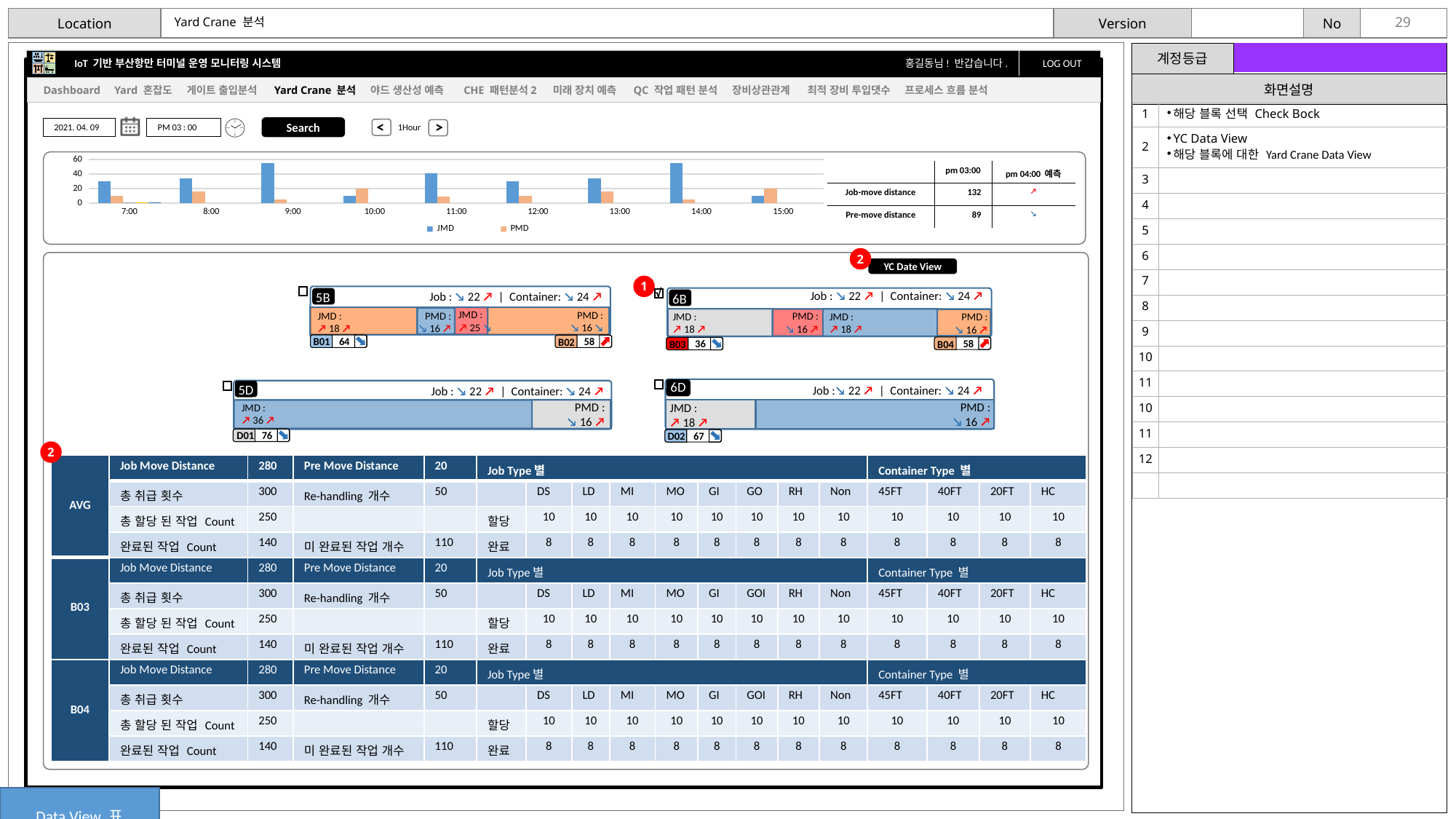
In the top bar chart, is the JMD value at 9:00 greater or less than 40? greater How many series does the legend of the top bar chart list? 2 In the top bar chart, which series has the larger value at 10:00, JMD or PMD? PMD In the top bar chart, is the JMD value at 11:00 greater or less than 20? greater How many time points are plotted along the x axis of the top bar chart? 9 In the top bar chart, is the JMD value at 10:00 greater or less than 20? less In the top bar chart, which series has the larger value at 15:00, JMD or PMD? PMD In the top bar chart, which series has the larger value at 9:00, JMD or PMD? JMD What kind of chart is shown at the top of the slide? bar chart What are the two series names shown in the legend of the top bar chart? JMD and PMD